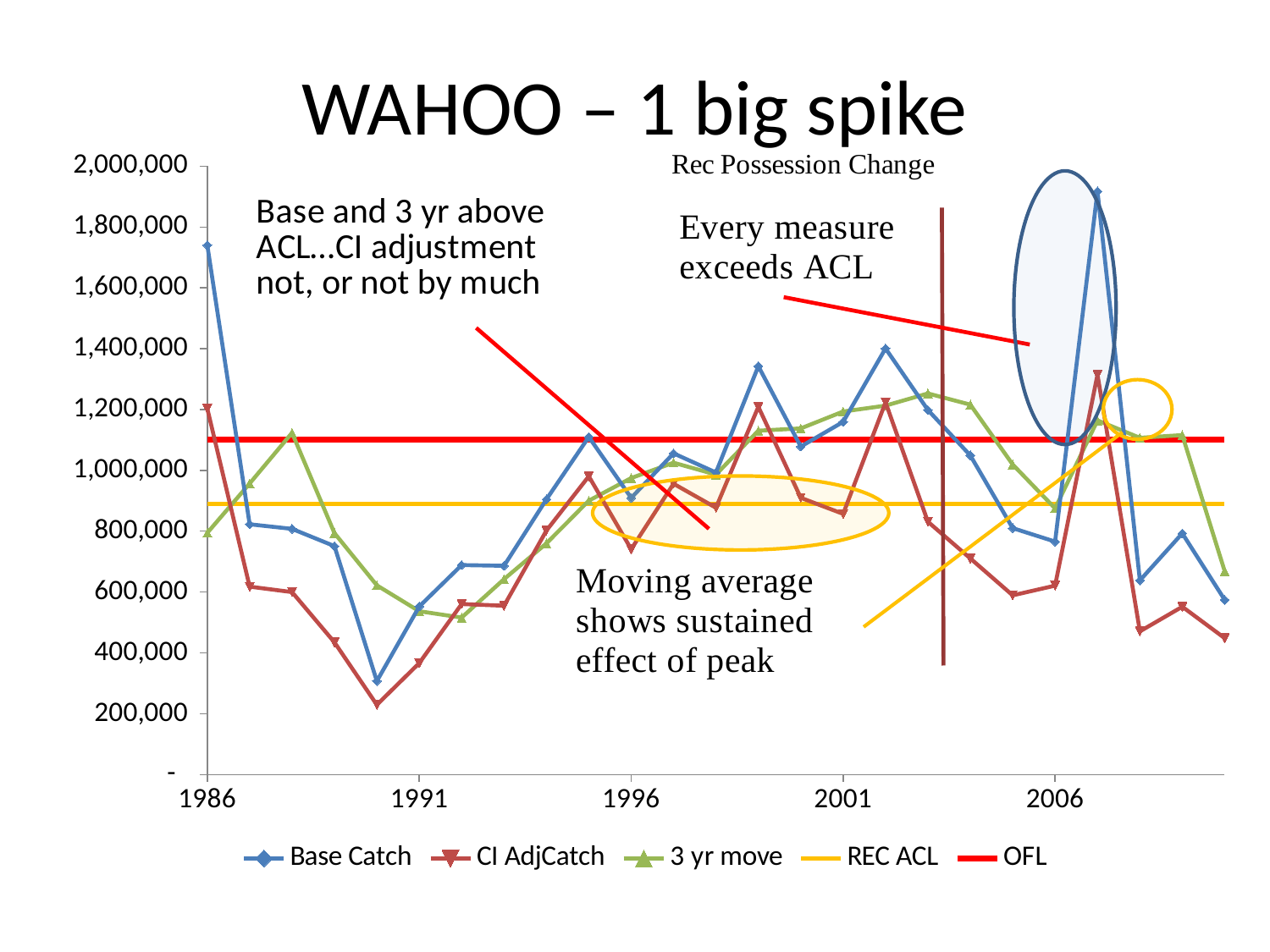
How many series does the legend list? 5 Does the Base Catch series rise or fall from 1986 to 1990? fall In which year does the Base Catch series reach its highest value? 2007 What is the title printed above the chart's plot area? Rec Possession Change Is the REC ACL line greater or less than 1,000,000? less In which year does the Base Catch series reach its lowest value? 1990 What are the series names listed in the legend? Base Catch, CI AdjCatch, 3 yr move, REC ACL, OFL Is the Base Catch value for 1986 greater or less than 1,600,000? greater In 2007, which is larger: Base Catch or CI AdjCatch? Base Catch Is the CI AdjCatch value for 1990 greater or less than 400,000? less What kind of chart is shown on the slide? line chart